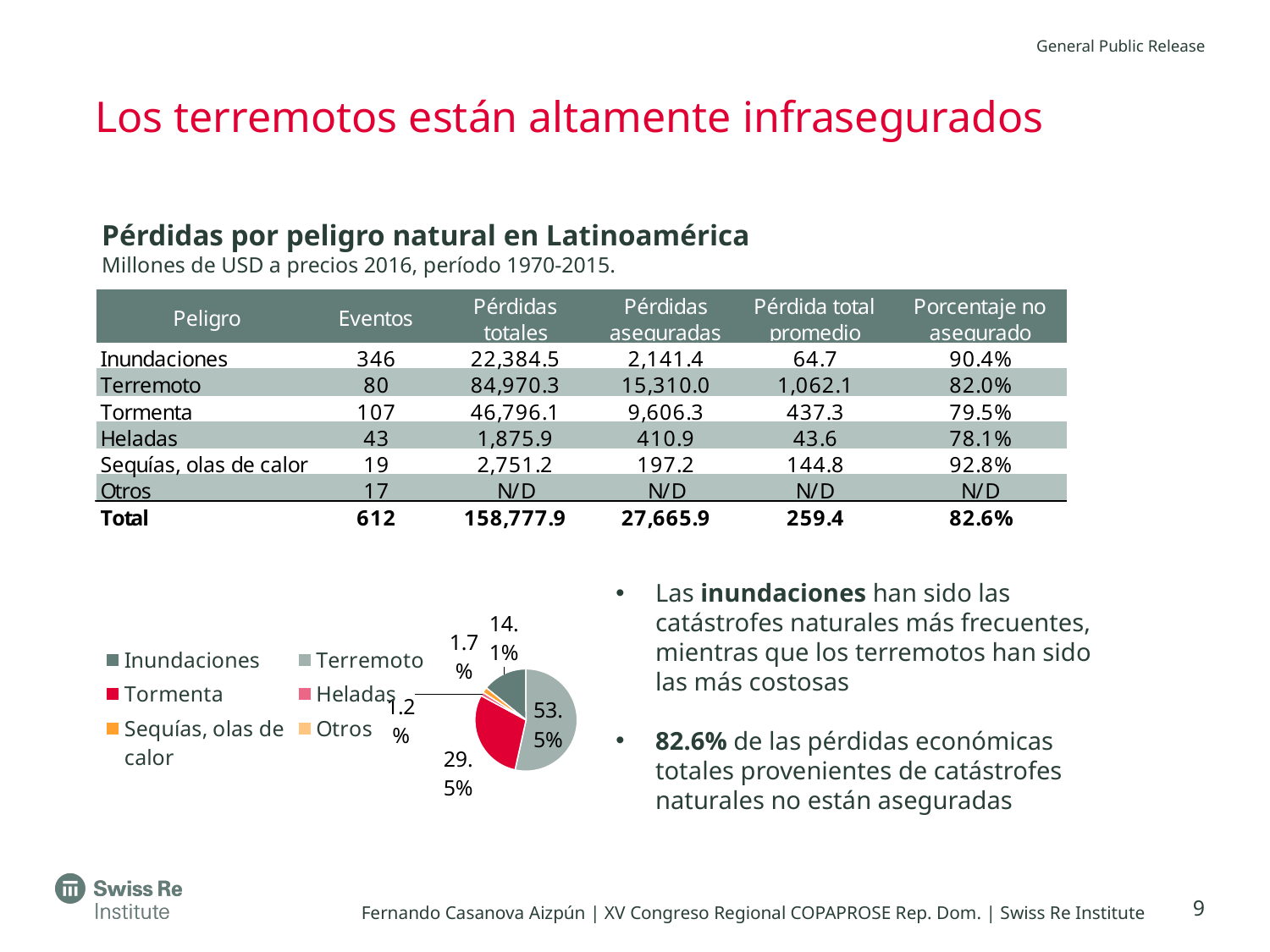
What is the share of Inundaciones in the pie chart? 14.1% Which legend entry of the pie chart is listed first? Inundaciones What percentage does the largest slice of the pie chart show? 53.5% What is the difference in percentage points between the Terremoto slice and the Tormenta slice? 24.0% What is the share of Tormenta in the pie chart? 29.5% What kind of chart is shown on the slide? pie chart What is the smallest percentage label shown on the pie chart? 1.2% Which legend entry of the pie chart is shown in red? Tormenta How many entries does the legend of the pie chart list? 6 Which category has the largest slice in the pie chart? Terremoto Which slice is larger in the pie chart, Tormenta or Inundaciones? Tormenta